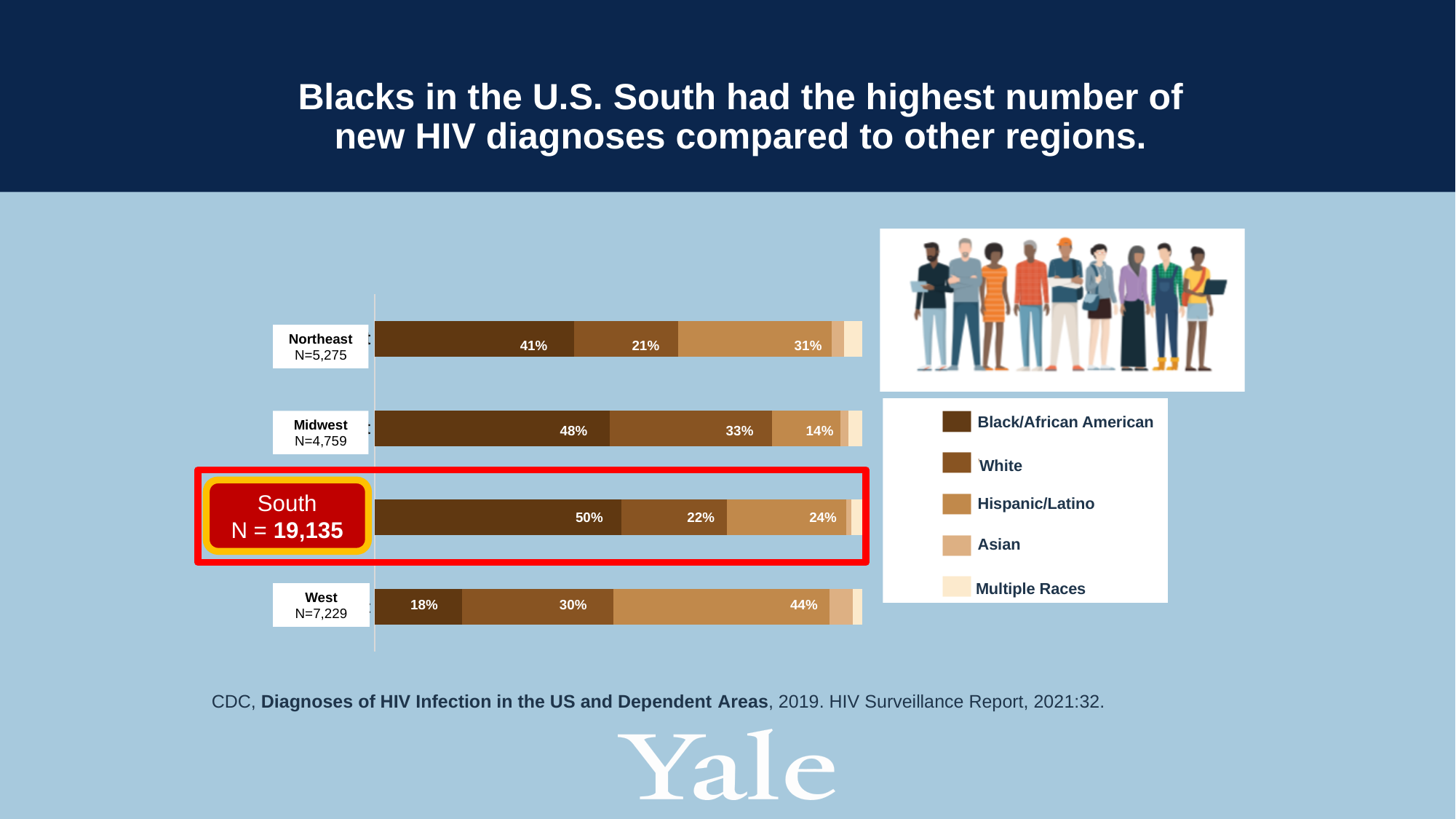
What percentage of new HIV diagnoses in the Midwest were among White people? 33% What is the N value shown for the South region? 19,135 Which region is highlighted with a red box on the chart? South Which region has the lowest Black/African American share of new HIV diagnoses? West Which region has the highest Black/African American share of new HIV diagnoses? South Which is larger: the Hispanic/Latino share in the Northeast or in the South? Northeast What is the difference between the Black/African American share in the Midwest and in the Northeast? 7% How many series does the legend list? 5 What percentage of new HIV diagnoses in the South were among Black/African American people? 50% How many regions are shown in the chart? 4 What kind of chart is shown on the slide? Stacked bar chart What percentage of new HIV diagnoses in the West were among Hispanic/Latino people? 44%